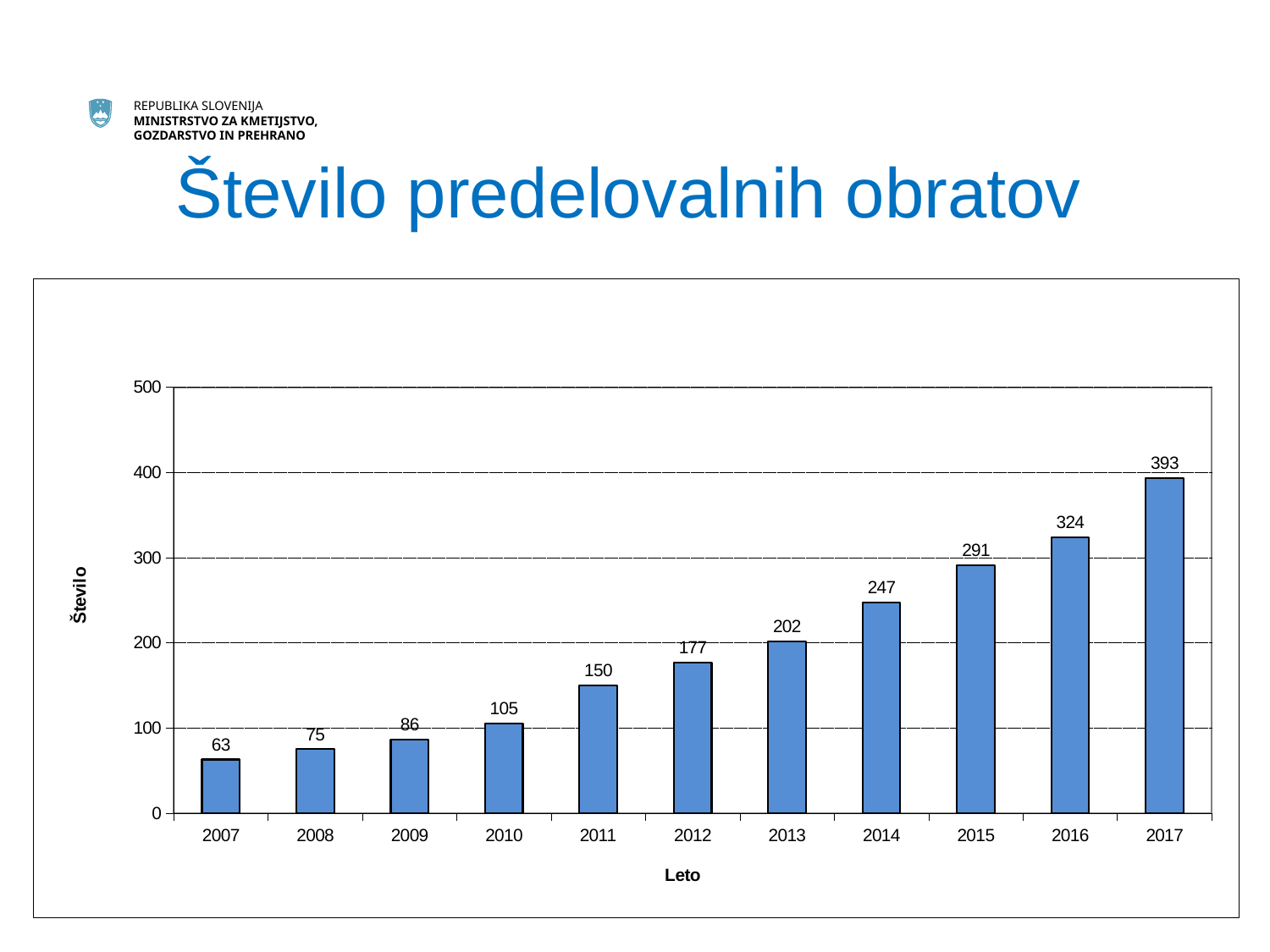
Do the values rise or fall from 2007 to 2017? rise What is the value for 2011? 150 What is the value for 2015? 291 What is the label of the x axis? Leto What kind of chart is shown on the slide? bar chart Which year has the lowest value? 2007 Which is larger, the value for 2012 or the value for 2014? 2014 Is the value for 2014 greater or less than 200? greater What is the difference between the values for 2013 and 2007? 139 How many years are shown on the x axis? 11 What is the difference between the values for 2017 and 2016? 69 Which year has the highest value? 2017